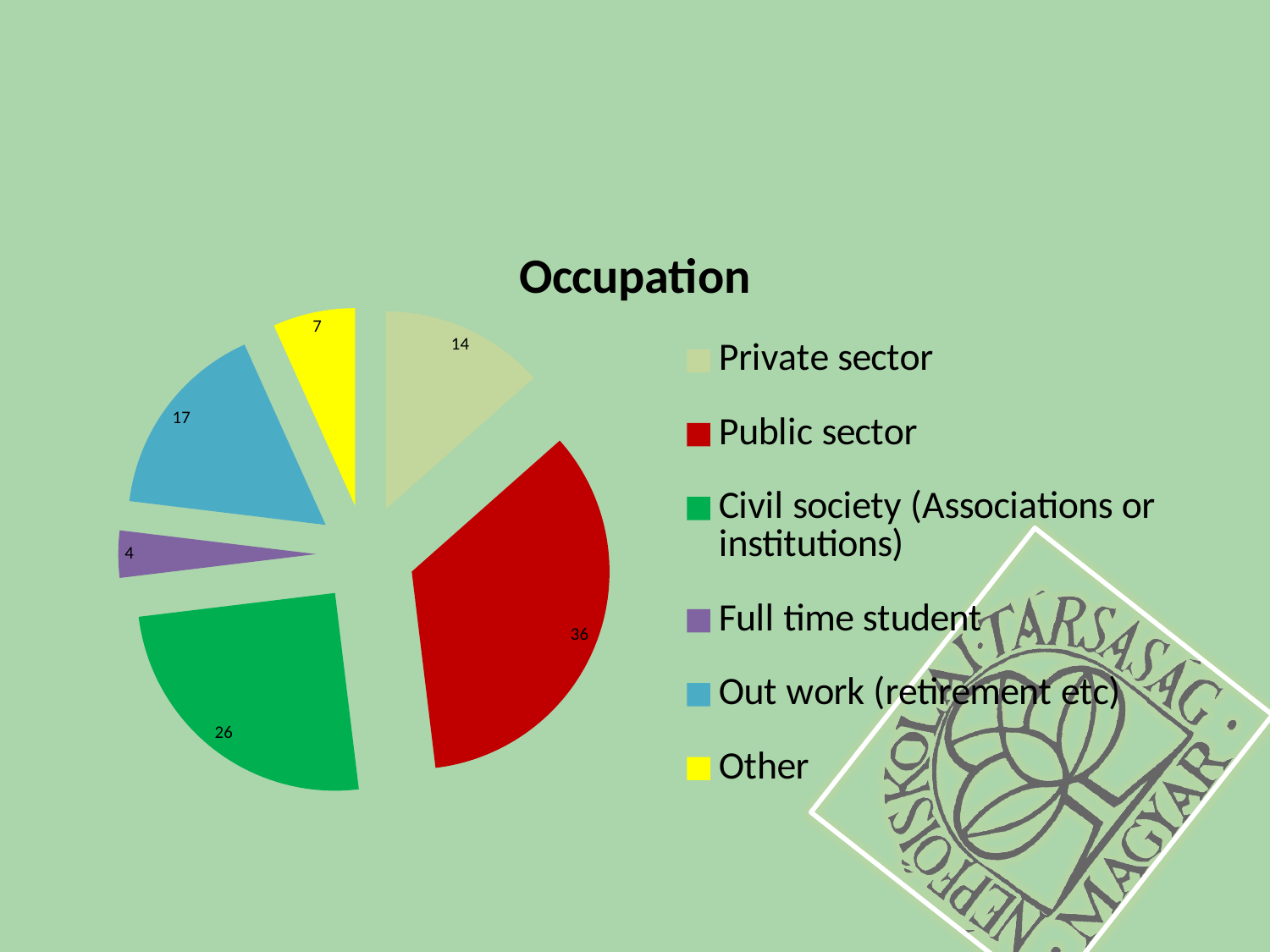
What is the value for Civil society (Associations or institutions) in the Occupation pie chart? 26 What kind of chart is shown on the slide? Pie chart What is the value for Public sector in the Occupation pie chart? 36 Which is larger in the Occupation pie chart, Out work (retirement etc) or Other? Out work (retirement etc) What is the title of the chart on the slide? Occupation Which category has the smallest slice in the Occupation pie chart? Full time student Which category has the largest slice in the Occupation pie chart? Public sector What is the value for Out work (retirement etc) in the Occupation pie chart? 17 What colour is the Other slice in the Occupation pie chart? Yellow How many slices does the Occupation pie chart have? 6 What is the value for Full time student in the Occupation pie chart? 4 What is the difference between the Public sector and Private sector values in the Occupation pie chart? 22